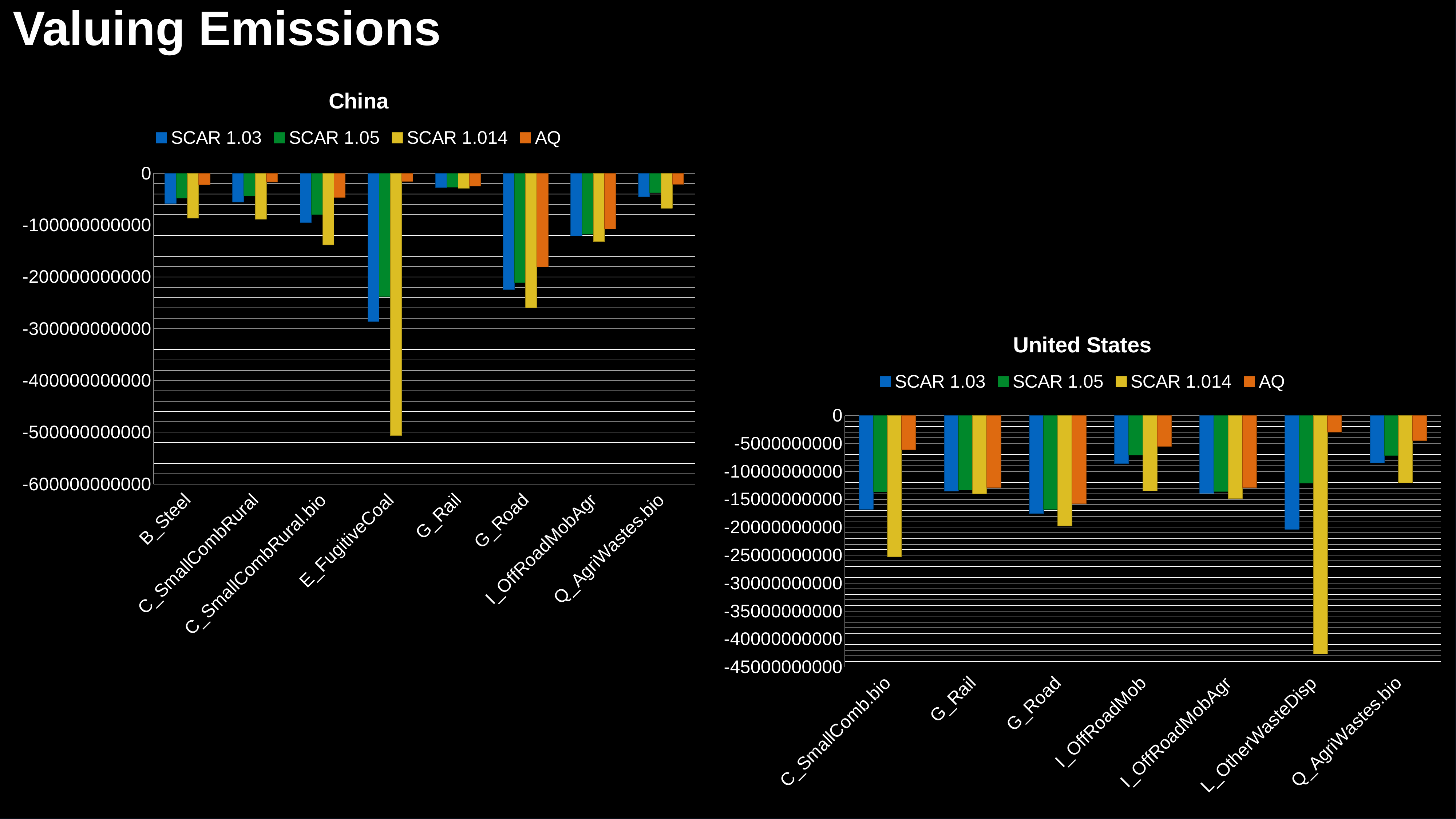
What kind of chart is the China chart? bar chart In the United States chart, which category has the most negative SCAR 1.014 value? L_OtherWasteDisp In the China chart, which colour represents the SCAR 1.014 series? yellow In the China chart, is the SCAR 1.014 value for E_FugitiveCoal greater or less than -400000000000? less In the China chart, is the SCAR 1.03 value for G_Road greater or less than -200000000000? less In the United States chart, is the SCAR 1.014 value for C_SmallComb.bio greater or less than -20000000000? less In the China chart, which category has the most negative SCAR 1.014 value? E_FugitiveCoal In the China chart, for E_FugitiveCoal, which is more negative: SCAR 1.03 or SCAR 1.05? SCAR 1.03 How many series does the legend of the United States chart list? 4 How many categories are shown on the x axis of the China chart? 8 How many categories are shown on the x axis of the United States chart? 7